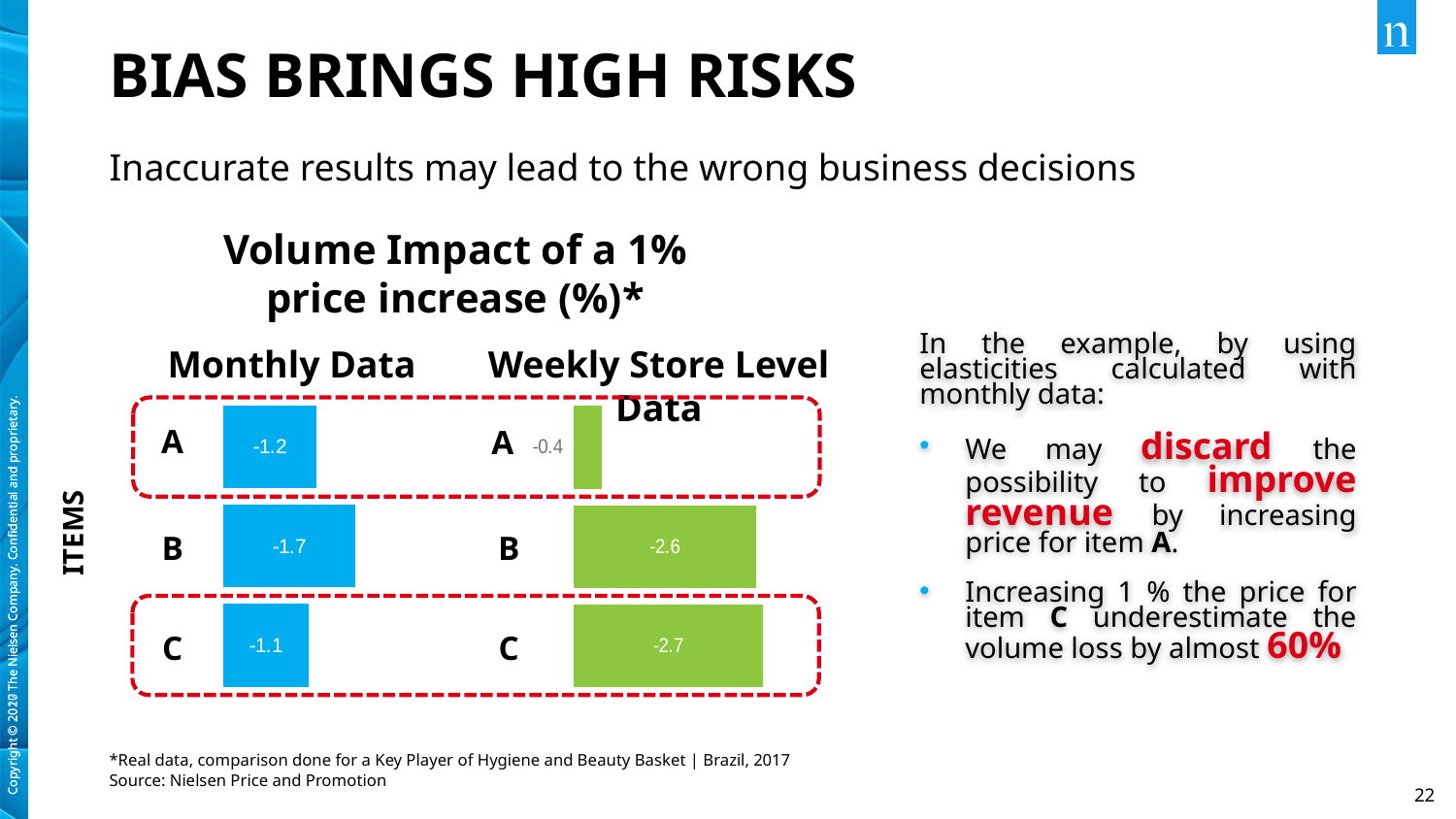
What is the difference between the Weekly Store Level Data value for item C (-2.7) and the Monthly Data value for item C (-1.1)? 1.6 How many items are plotted in the Monthly Data chart? 3 For item A, which chart shows the larger volume impact (more negative value): Monthly Data or Weekly Store Level Data? Monthly Data In the Weekly Store Level Data chart, what is the value for item C? -2.7 What colour are the bars in the Monthly Data chart? Blue In the Monthly Data chart, which item has the largest bar (most negative value)? B In the Weekly Store Level Data chart, which item has the smallest bar (value closest to zero)? A In the Monthly Data chart, what is the value for item B? -1.7 What type of chart is the Weekly Store Level Data chart? Bar chart In the Weekly Store Level Data chart, what is the value for item A? -0.4 In the Monthly Data chart, what is the value for item A? -1.2 What is the difference between the Weekly Store Level Data value for item B (-2.6) and the Monthly Data value for item B (-1.7)? 0.9